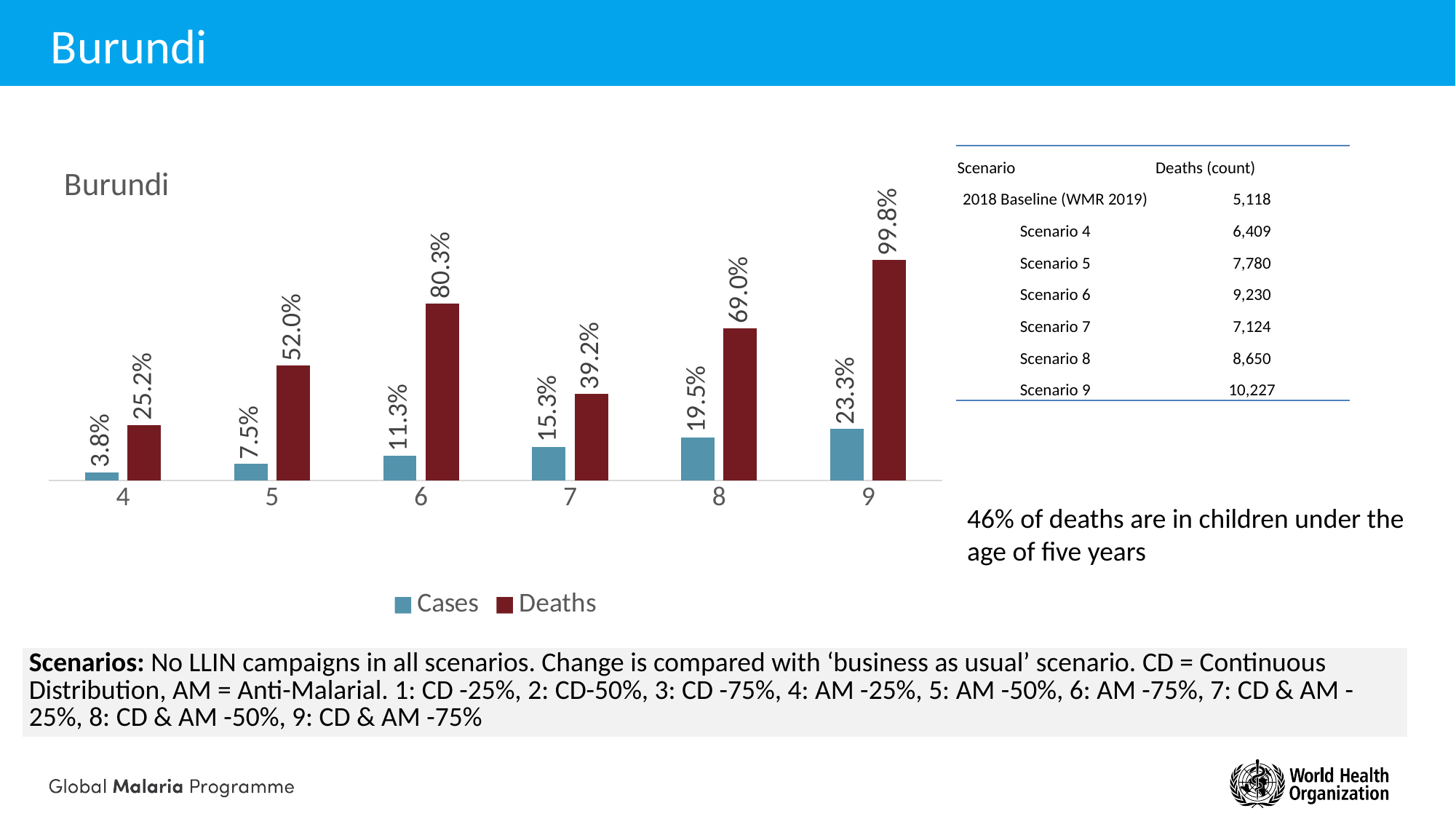
What kind of chart is shown on the slide? Bar chart Which scenario has the highest Deaths value? 9 How many scenarios are shown on the x axis of the chart? 6 What is the Deaths value for scenario 9? 99.8% What is the Deaths value for scenario 6? 80.3% Do the Cases values rise or fall from scenario 4 to scenario 9? Rise Which is larger, the Deaths value for scenario 6 or for scenario 7? Scenario 6 What is the Cases value for scenario 7? 15.3% How many series does the chart legend list? 2 What is the difference between the Deaths and Cases values for scenario 8? 49.5% Which scenario has the lowest Cases value? 4 What is the Cases value for scenario 4? 3.8%